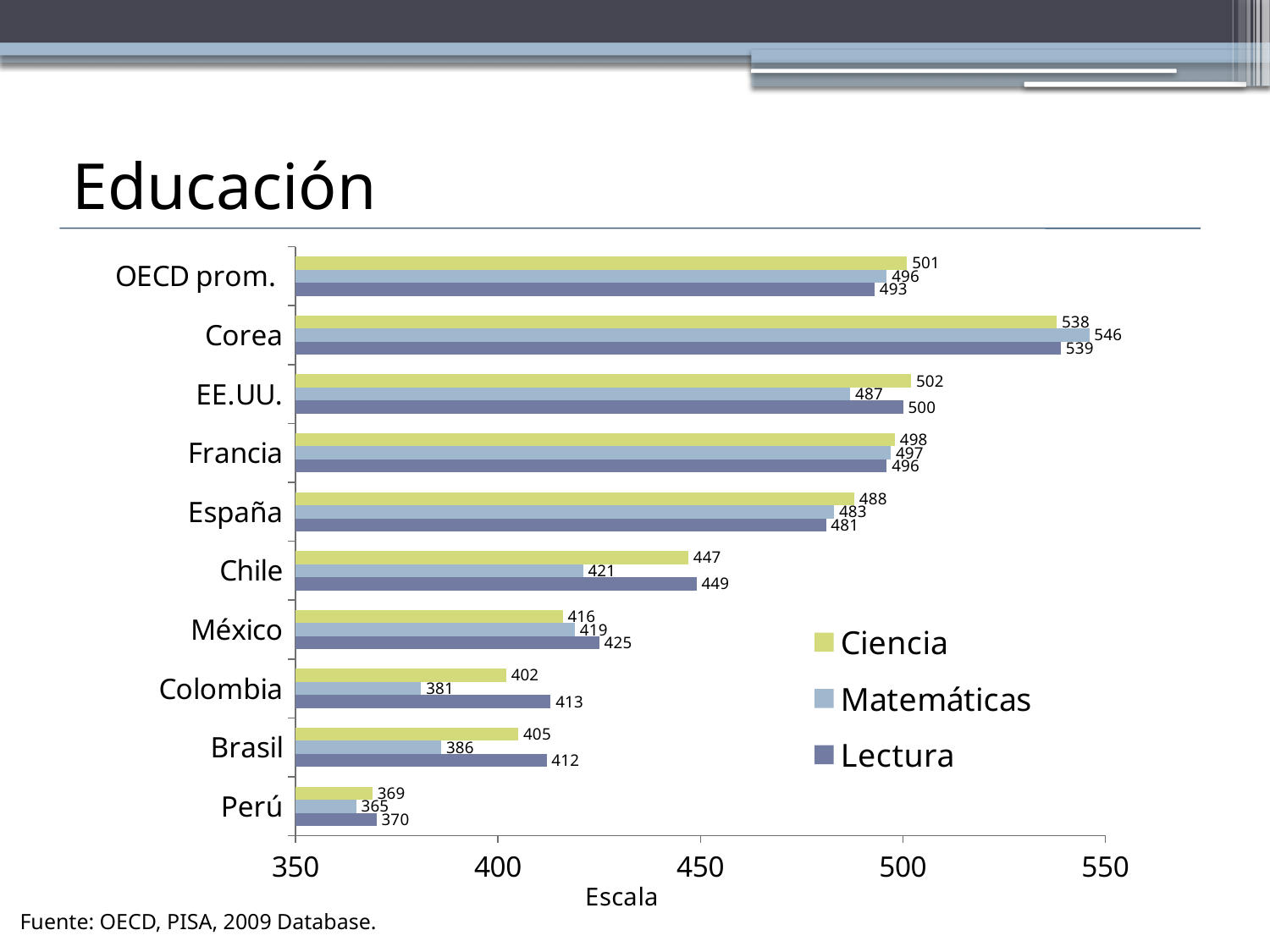
What is the Lectura value for Colombia? 413 Which country has the lowest Lectura value? Perú Which is larger for Chile, the Ciencia value or the Lectura value? Lectura Is the Matemáticas value for Colombia greater or less than 400? less What is the difference between the Ciencia value for EE.UU. and the Ciencia value for Brasil? 97 What is the Ciencia value for Chile? 447 What kind of chart is shown on the slide? bar chart How many countries or groups are shown on the chart? 10 What is the Matemáticas value for Corea? 546 How many series does the legend list? 3 What is the label of the horizontal axis? Escala Which country has the highest Matemáticas value? Corea